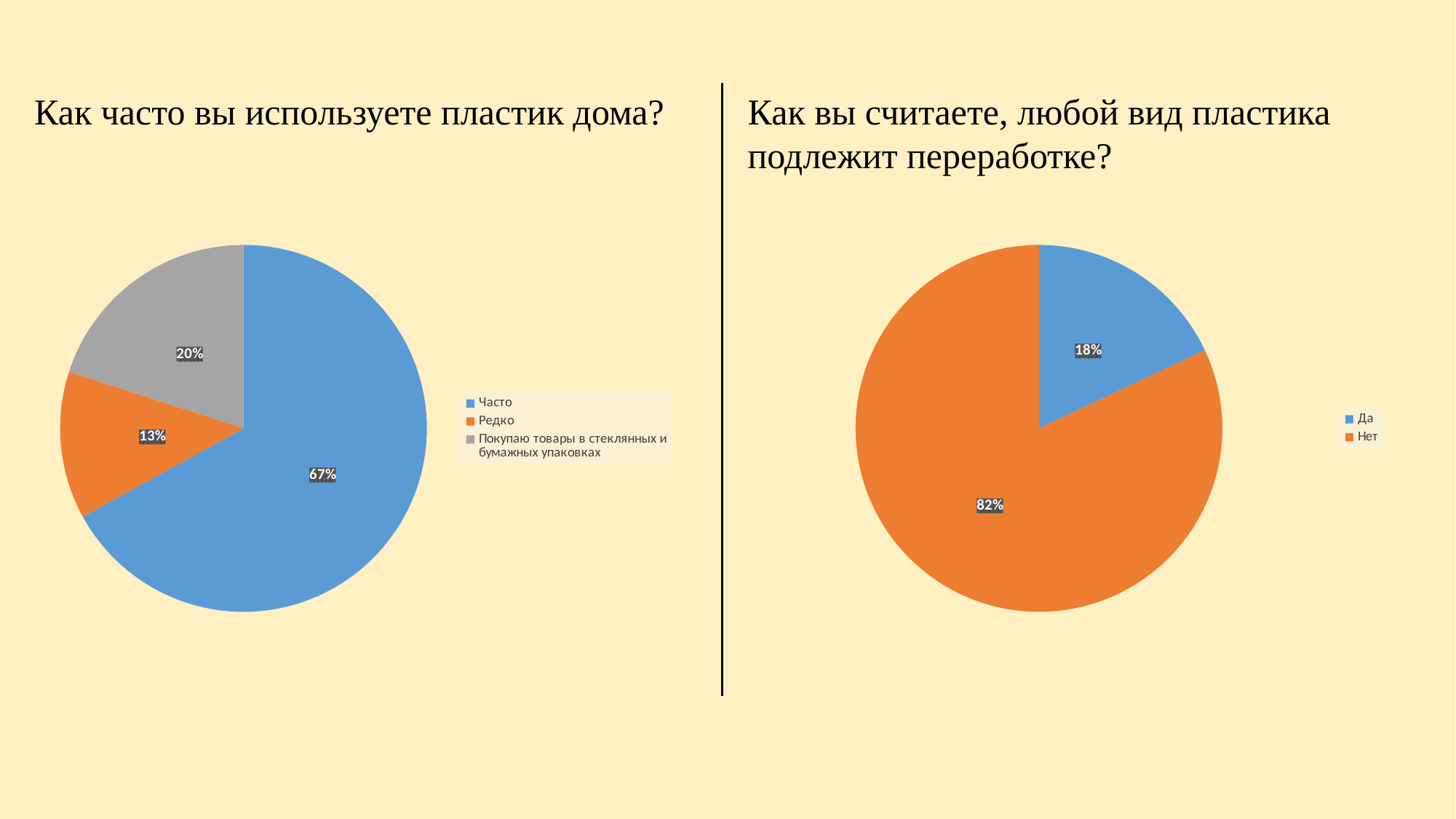
In the left pie chart (Как часто вы используете пластик дома?), what is the difference in percentage points between Часто and Редко? 54 In the right pie chart (Как вы считаете, любой вид пластика подлежит переработке?), what share is labelled for Да? 18% In the right pie chart (Как вы считаете, любой вид пластика подлежит переработке?), what share is labelled for Нет? 82% What type of chart is shown on the right side of the slide? Pie chart In the left pie chart (Как часто вы используете пластик дома?), what share is labelled for Покупаю товары в стеклянных и бумажных упаковках? 20% In the left pie chart (Как часто вы используете пластик дома?), what share is labelled for Часто? 67% In the left pie chart (Как часто вы используете пластик дома?), what share is labelled for Редко? 13% In the left pie chart (Как часто вы используете пластик дома?), how many slices does the pie have? 3 In the left pie chart (Как часто вы используете пластик дома?), which category has the smallest slice? Редко In the right pie chart (Как вы считаете, любой вид пластика подлежит переработке?), how many entries does the legend list? 2 In the right pie chart (Как вы считаете, любой вид пластика подлежит переработке?), which is larger, Да or Нет? Нет In the left pie chart (Как часто вы используете пластик дома?), which category has the largest slice? Часто